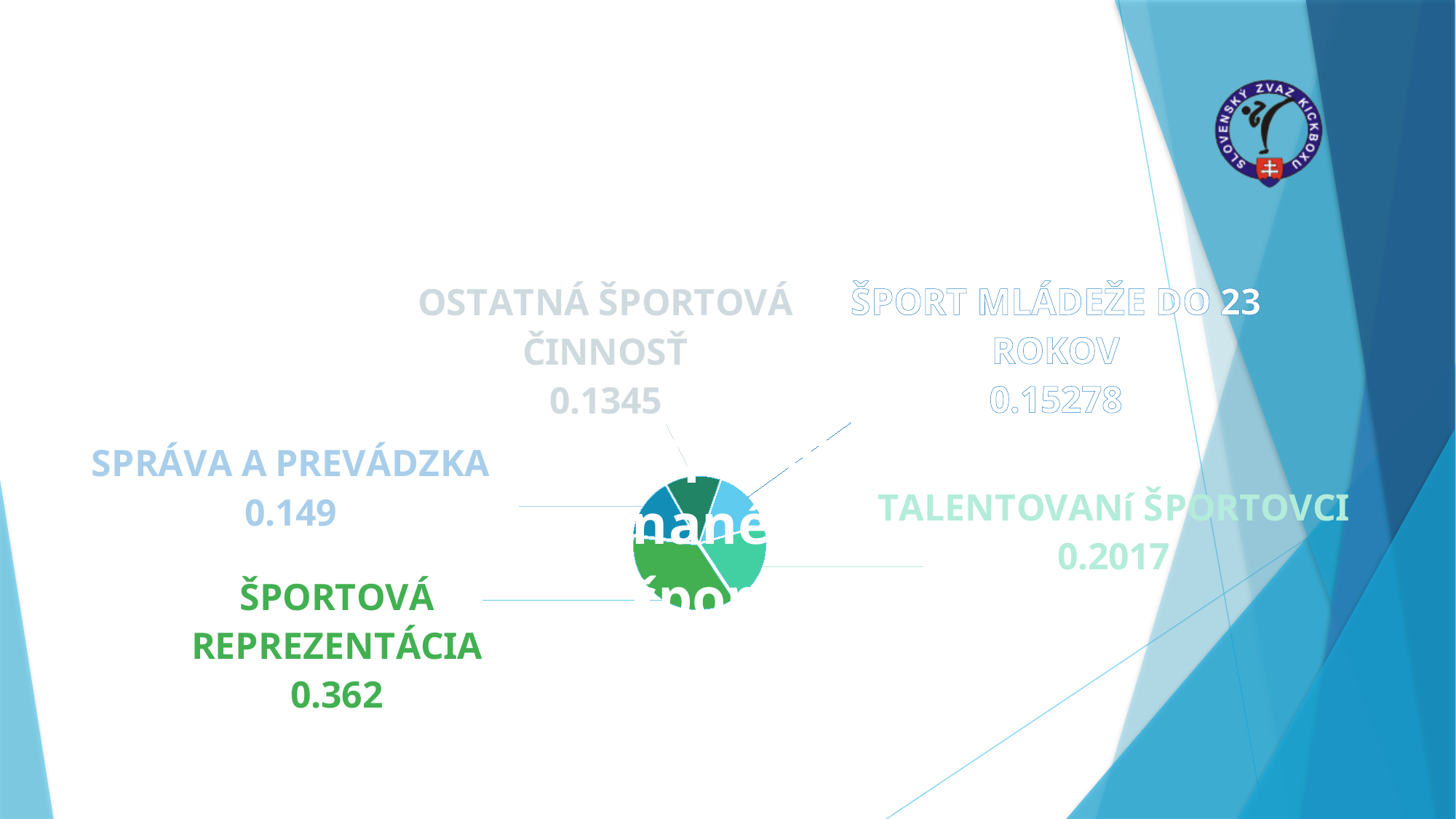
What kind of chart is shown on the slide? pie chart What is the value shown for TALENTOVANÍ ŠPORTOVCI? 0.2017 What is the value shown for ŠPORT MLÁDEŽE DO 23 ROKOV? 0.15278 What is the value shown for OSTATNÁ ŠPORTOVÁ ČINNOSŤ? 0.1345 Which category has the smallest slice of the pie? OSTATNÁ ŠPORTOVÁ ČINNOSŤ What is the difference between the values for ŠPORTOVÁ REPREZENTÁCIA and TALENTOVANÍ ŠPORTOVCI? 0.1603 What colour is the ŠPORTOVÁ REPREZENTÁCIA label text? green Which category has the largest slice of the pie? ŠPORTOVÁ REPREZENTÁCIA What is the value shown for ŠPORTOVÁ REPREZENTÁCIA? 0.362 Which has the larger value, ŠPORT MLÁDEŽE DO 23 ROKOV or SPRÁVA A PREVÁDZKA? ŠPORT MLÁDEŽE DO 23 ROKOV What is the value shown for SPRÁVA A PREVÁDZKA? 0.149 How many slices does the pie chart have? 5